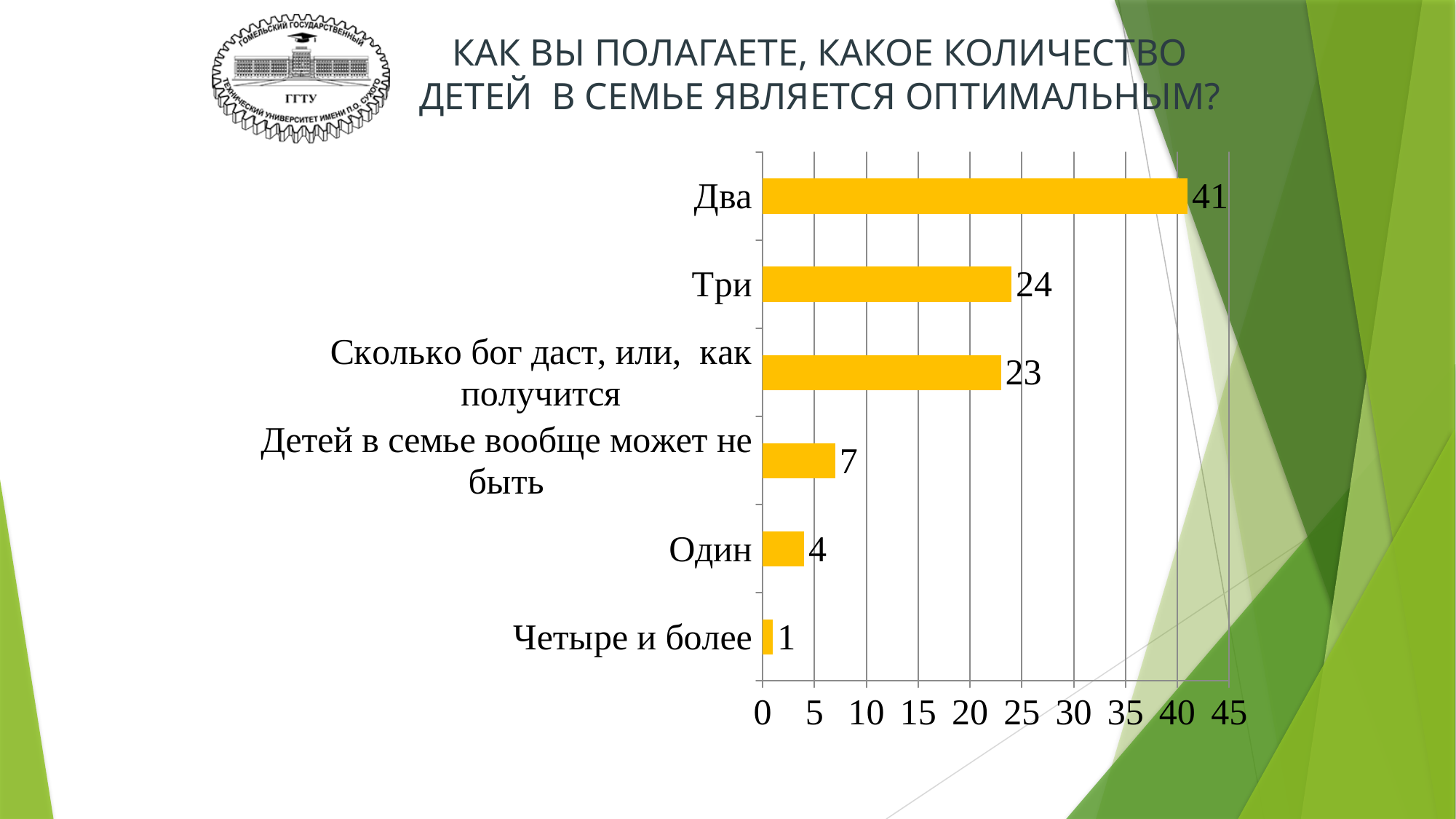
What is the value for "Четыре и более"? 1 What is the value for "Один"? 4 How many categories are shown in the chart? 6 What is the value for "Сколько бог даст, или, как получится"? 23 What kind of chart is shown on the slide? Bar chart What is the value for "Три"? 24 What is the value for "Два"? 41 Which category has the lowest value? Четыре и более Which is larger, the value for "Один" or the value for "Детей в семье вообще может не быть"? Детей в семье вообще может не быть What is the difference between the values for "Два" and "Три"? 17 Which category has the highest value? Два What is the value for "Детей в семье вообще может не быть"? 7